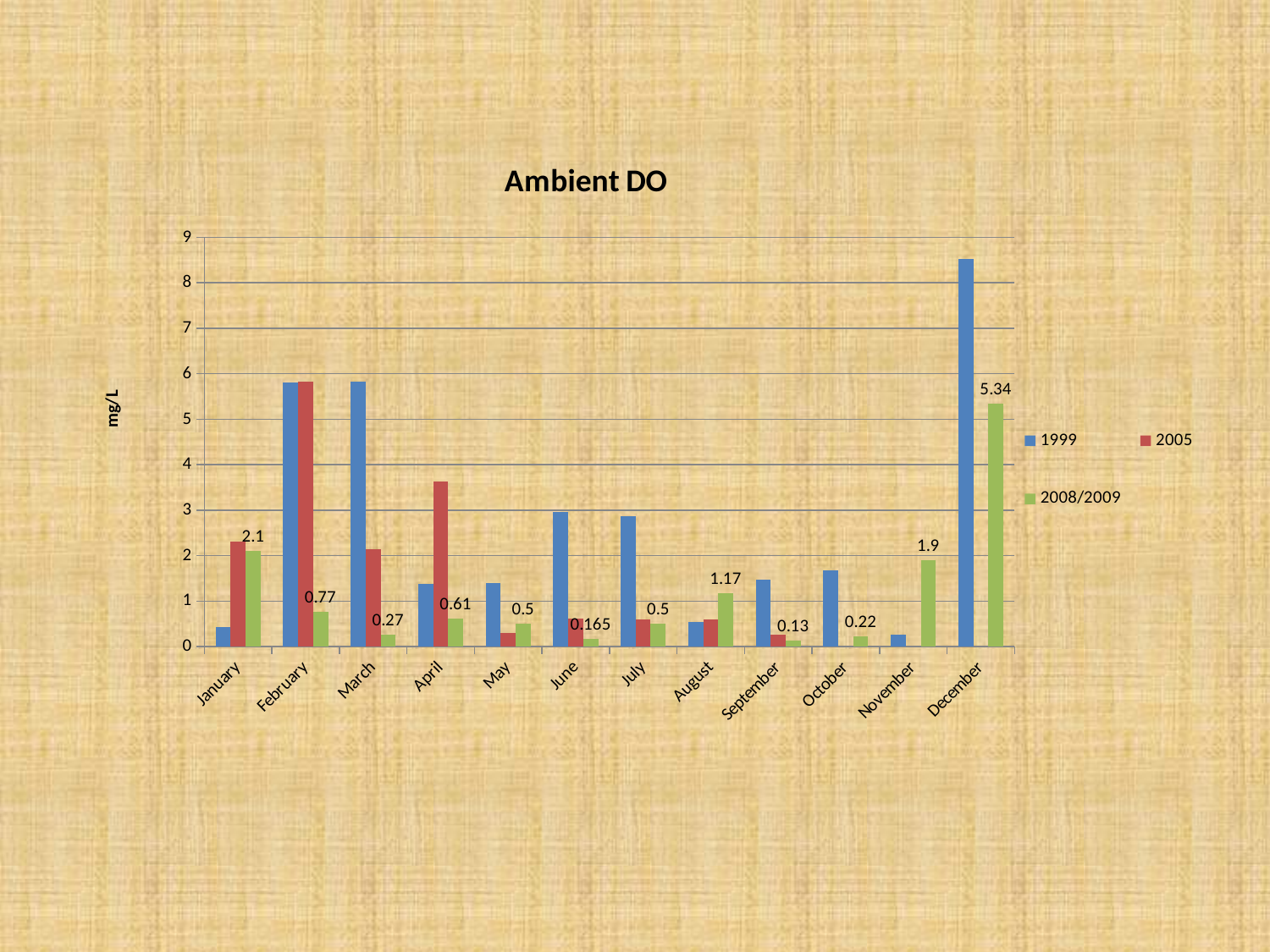
Which month has the lowest 2008/2009 value? September What is the 2008/2009 value for December? 5.34 How many months are shown on the x axis? 12 What is the difference between the 2008/2009 values for December and November? 3.44 What is the 2008/2009 value for January? 2.1 How many series does the legend list? 3 Is the 2005 value for April greater or less than 3? greater What kind of chart is shown? bar chart Which month has the highest 2008/2009 value? December Is the 1999 value for December greater or less than 8? greater Which is larger, the 2008/2009 value for August or for February? August What is the 2008/2009 value for June? 0.165